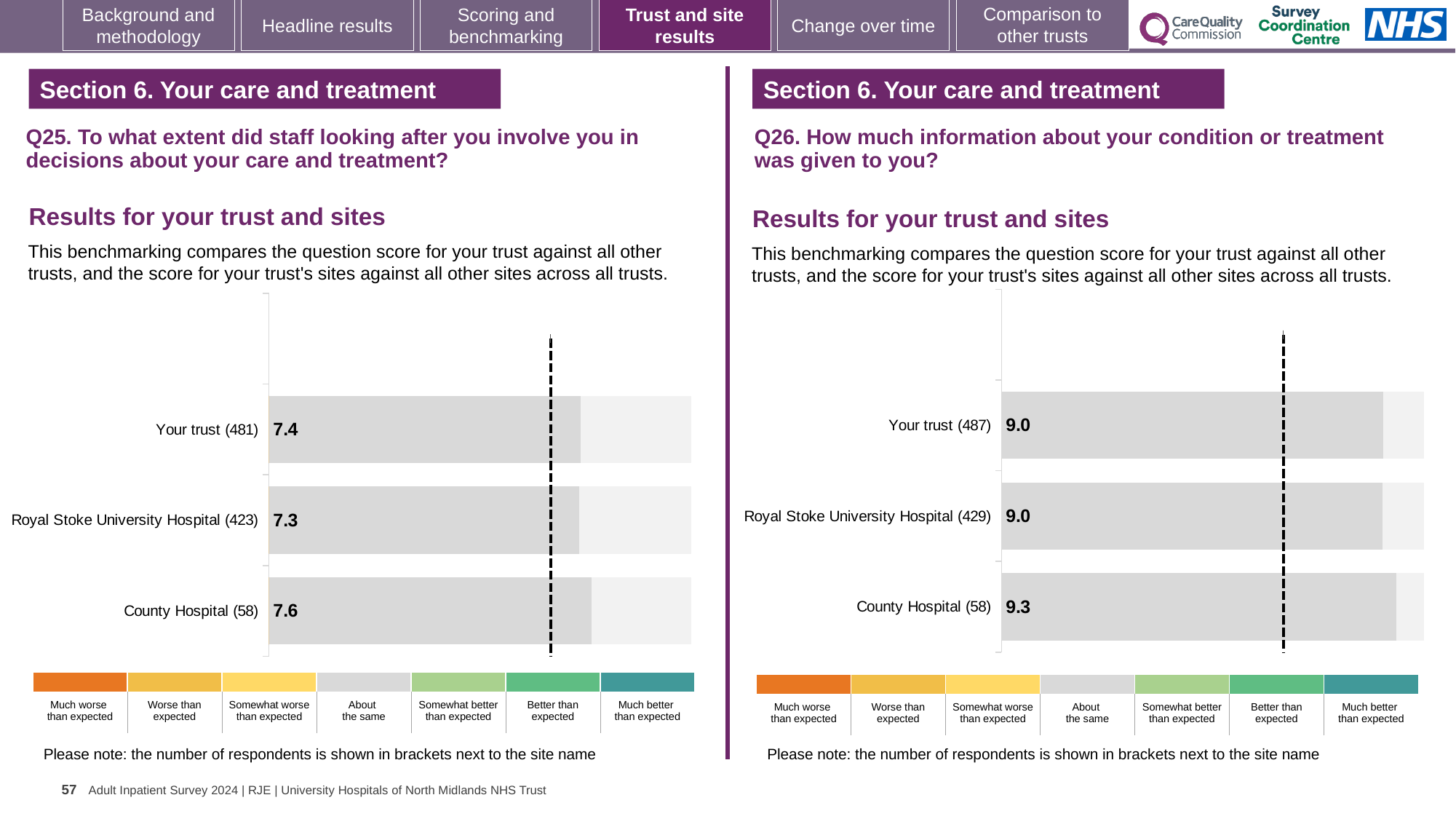
How many bars are plotted in the Q26 chart on the right? 3 In the Q25 chart on the left, what is the score for Royal Stoke University Hospital (423)? 7.3 In the Q25 chart on the left, which site or trust has the lowest score? Royal Stoke University Hospital (423) In the Q26 chart on the right, which site or trust has the highest score? County Hospital (58) In the Q26 chart on the right, what is the difference between the scores for County Hospital (58) and Your trust (487)? 0.3 In the Q25 chart on the left, which site or trust has the highest score? County Hospital (58) In the Q25 chart on the left, what is the score for County Hospital (58)? 7.6 What kind of chart is used for the Q25 results on the left? Bar chart In the Q26 chart on the right, what is the score for Your trust (487)? 9.0 In the Q26 chart on the right, what is the score for County Hospital (58)? 9.3 In the Q25 chart on the left, what is the difference between the scores for County Hospital (58) and Royal Stoke University Hospital (423)? 0.3 In the Q25 chart on the left, what is the score for Your trust (481)? 7.4